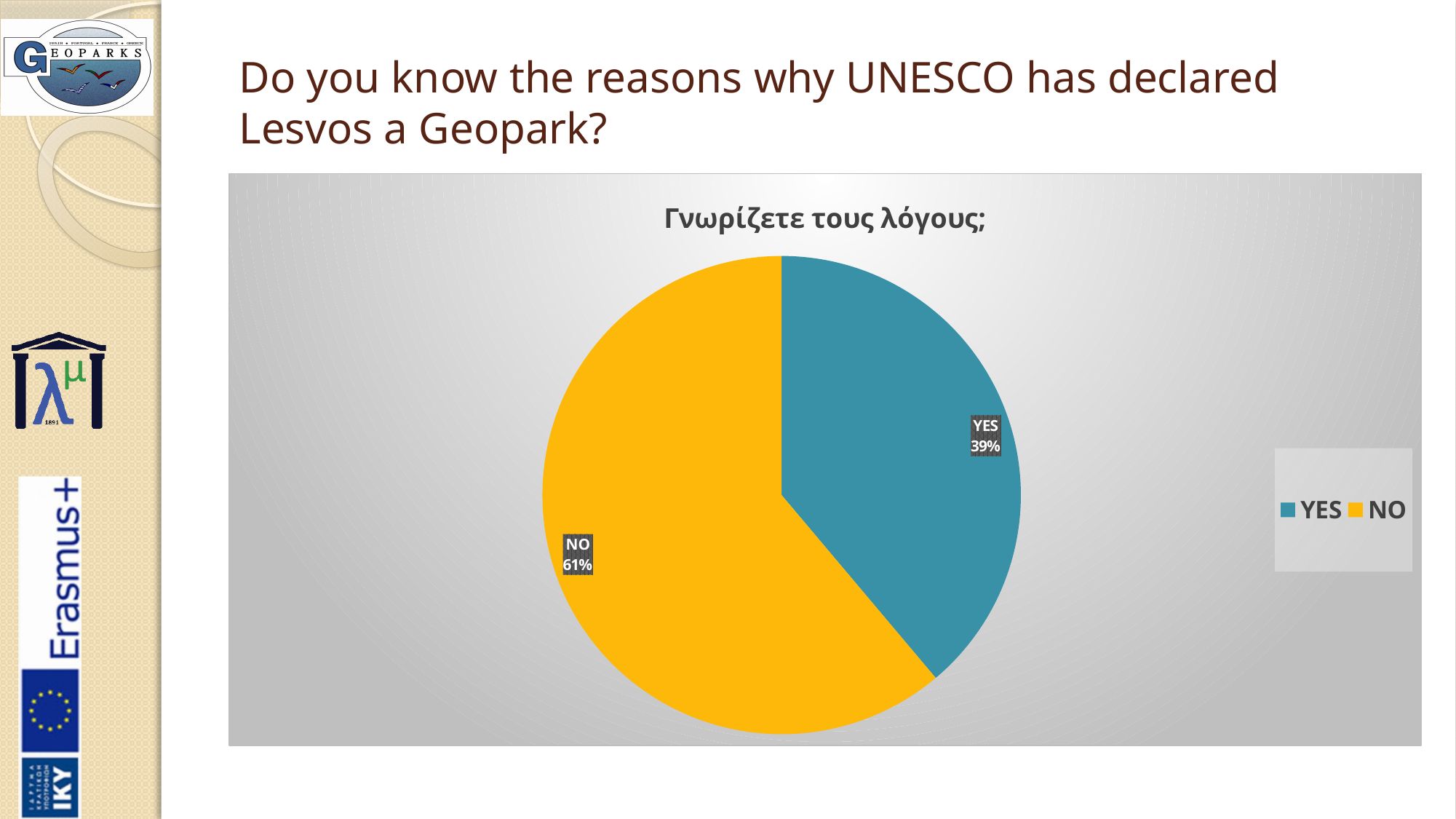
Which response has the largest share of the pie? NO How many slices does the pie chart have? 2 What percentage of respondents answered NO? 61% What is the title shown above the pie chart? Γνωρίζετε τους λόγους; How many entries does the legend list? 2 What is the difference in percentage points between the NO and YES slices? 22 Which is larger, the YES slice or the NO slice? NO What colour is the NO slice in the pie chart? yellow Which response has the smallest share of the pie? YES What share of the pie does the NO slice represent? 61% What type of chart is shown on the slide? pie chart What percentage of respondents answered YES? 39%